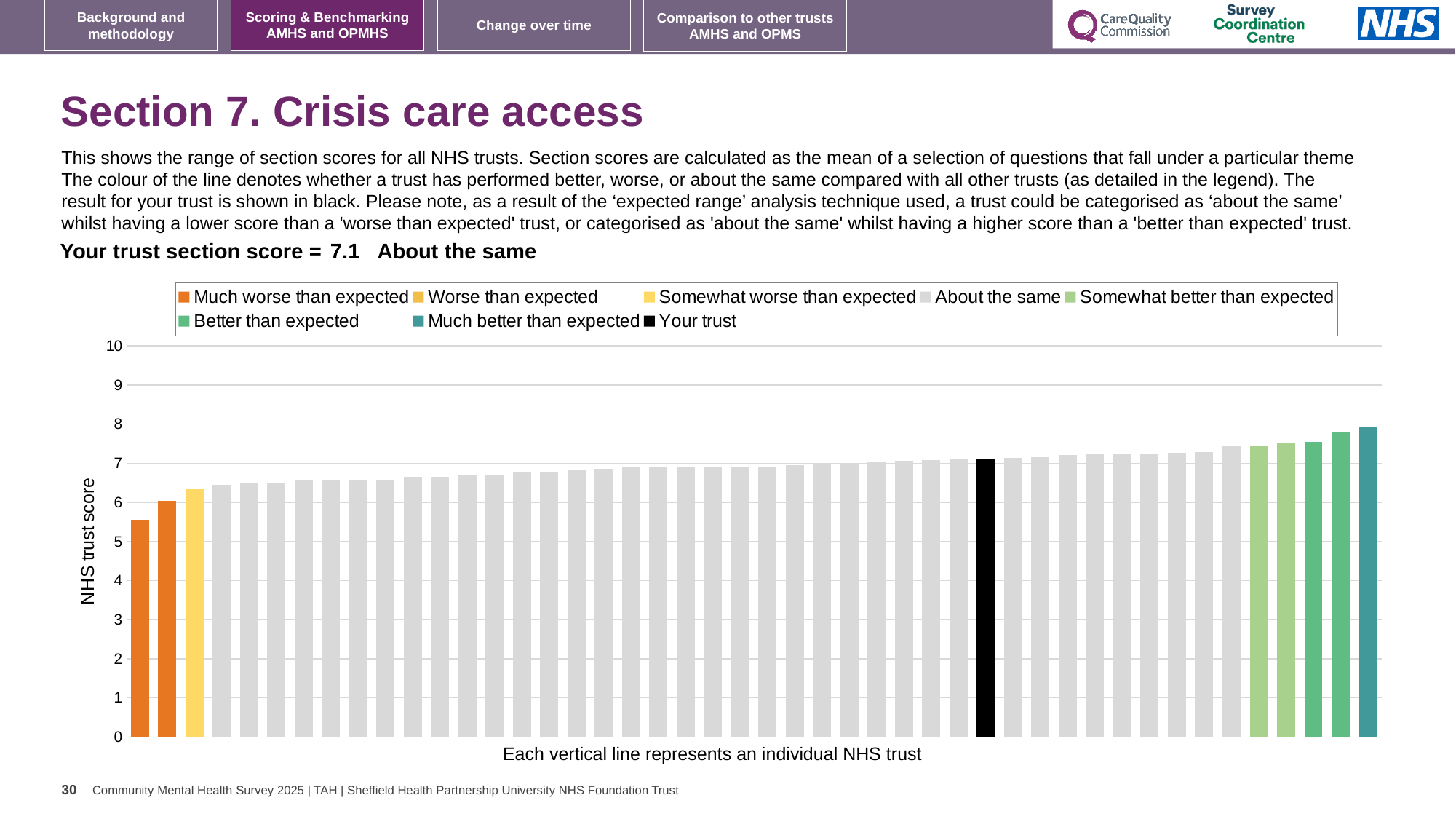
How many bars are coloured orange (Much worse than expected)? 2 What colour is used for the bar representing your trust? black Which is larger, the leftmost bar or the black bar for your trust? the black bar for your trust Is the value of the tallest bar greater or less than 7? greater Do the bar values rise or fall from left to right along the x axis? rise Is the value of the black bar (your trust) greater or less than 7? greater How many entries does the chart legend list? 8 What kind of chart is shown on the slide? bar chart Is the value of the leftmost bar greater or less than 6? less What is the section score for your trust shown on the slide? 7.1 Which category is your trust placed in for Section 7 Crisis care access? About the same What is the label on the vertical axis of the chart? NHS trust score